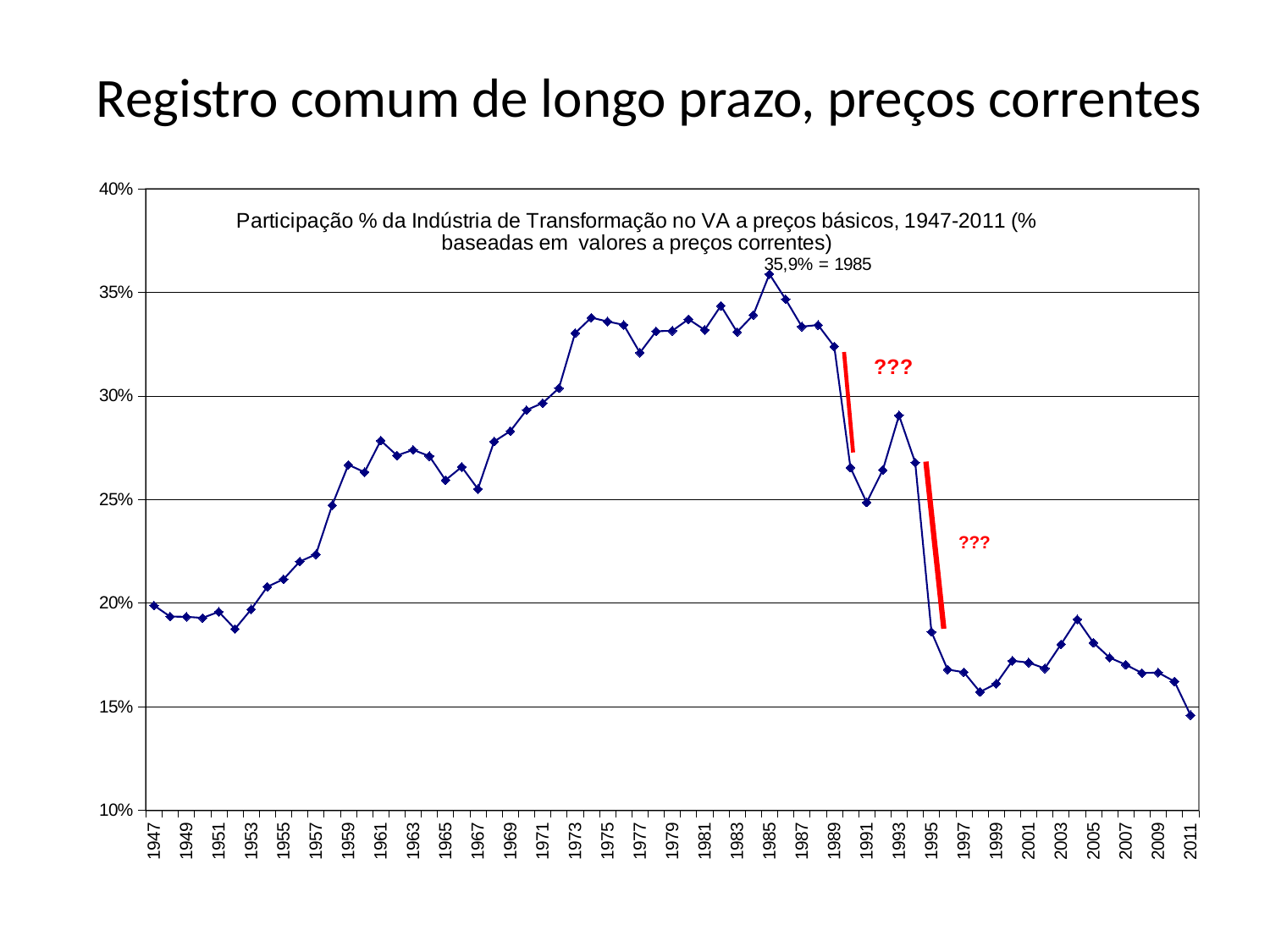
Which year has the larger value, 1947 or 1973? 1973 What is the first year and the last year shown on the x axis? 1947 and 2011 Do the values generally rise or fall between 1985 and 2011? fall Is the value for 1995 greater or less than 20%? less In which year does the series reach its lowest value? 2011 In which year does the series reach its highest value? 1985 What kind of chart is shown on the slide? line chart Is the value for 1961 greater or less than 25%? greater What value is labelled on the chart for the year 1985? 35,9% Is the value for 1947 greater or less than 25%? less Do the values generally rise or fall between 1947 and 1973? rise